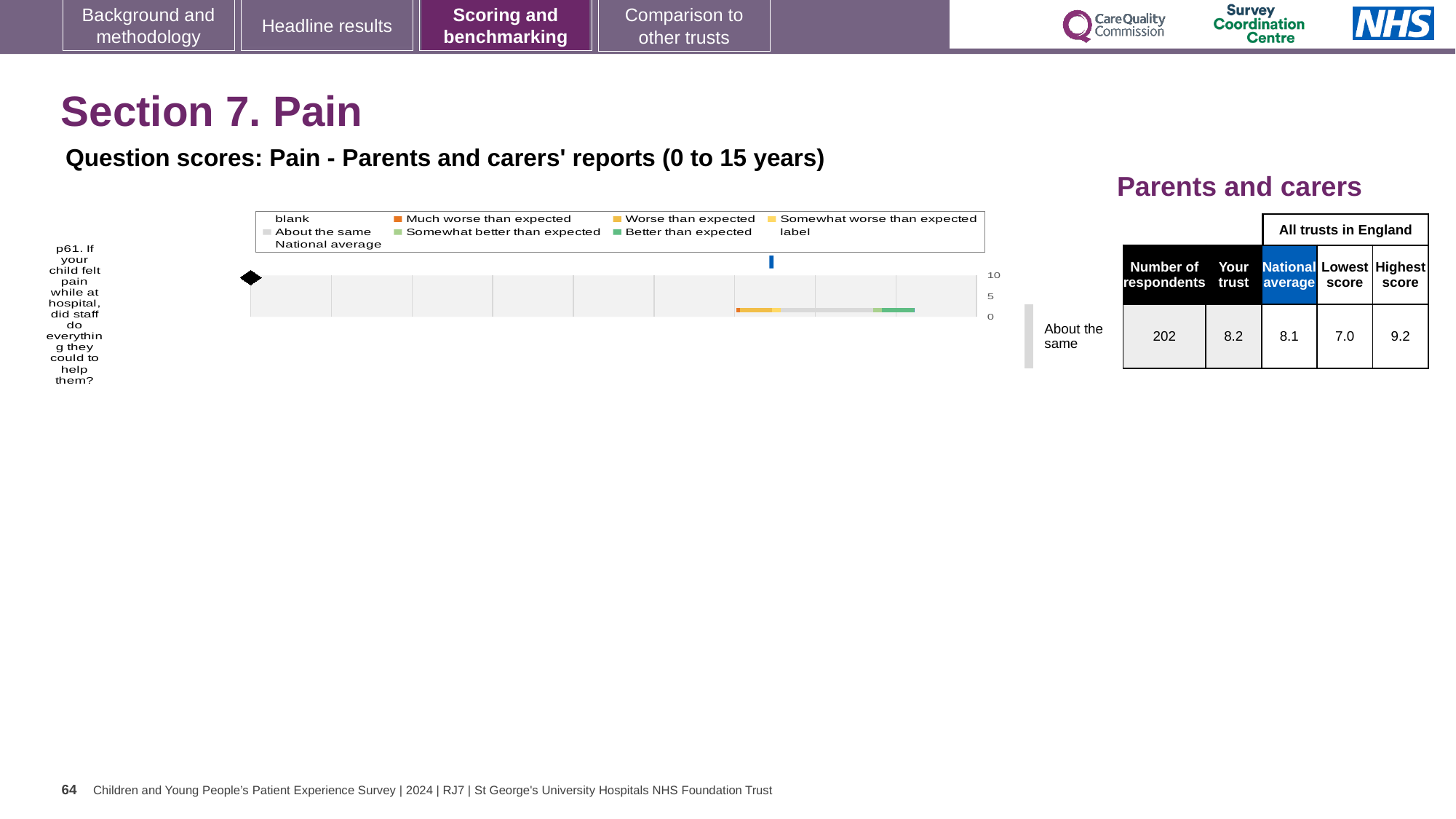
What is the difference between the highest score and the lowest score for question p61? 2.2 What colour does the legend use for 'Much worse than expected'? orange What is the national average score for question p61? 8.1 How many respondents answered question p61? 202 How many entries does the chart legend list? 9 What is the 'Your trust' score for question p61 in the Parents and carers table? 8.2 Which is larger for question p61: the 'Your trust' score or the national average? Your trust Which benchmark category is the trust's score for p61 placed in, according to the label next to the table? About the same What kind of chart is shown on the slide? bar chart How many survey questions (categories) are plotted in the chart? 1 What is the highest score among all trusts in England for question p61? 9.2 What is the lowest score among all trusts in England for question p61? 7.0